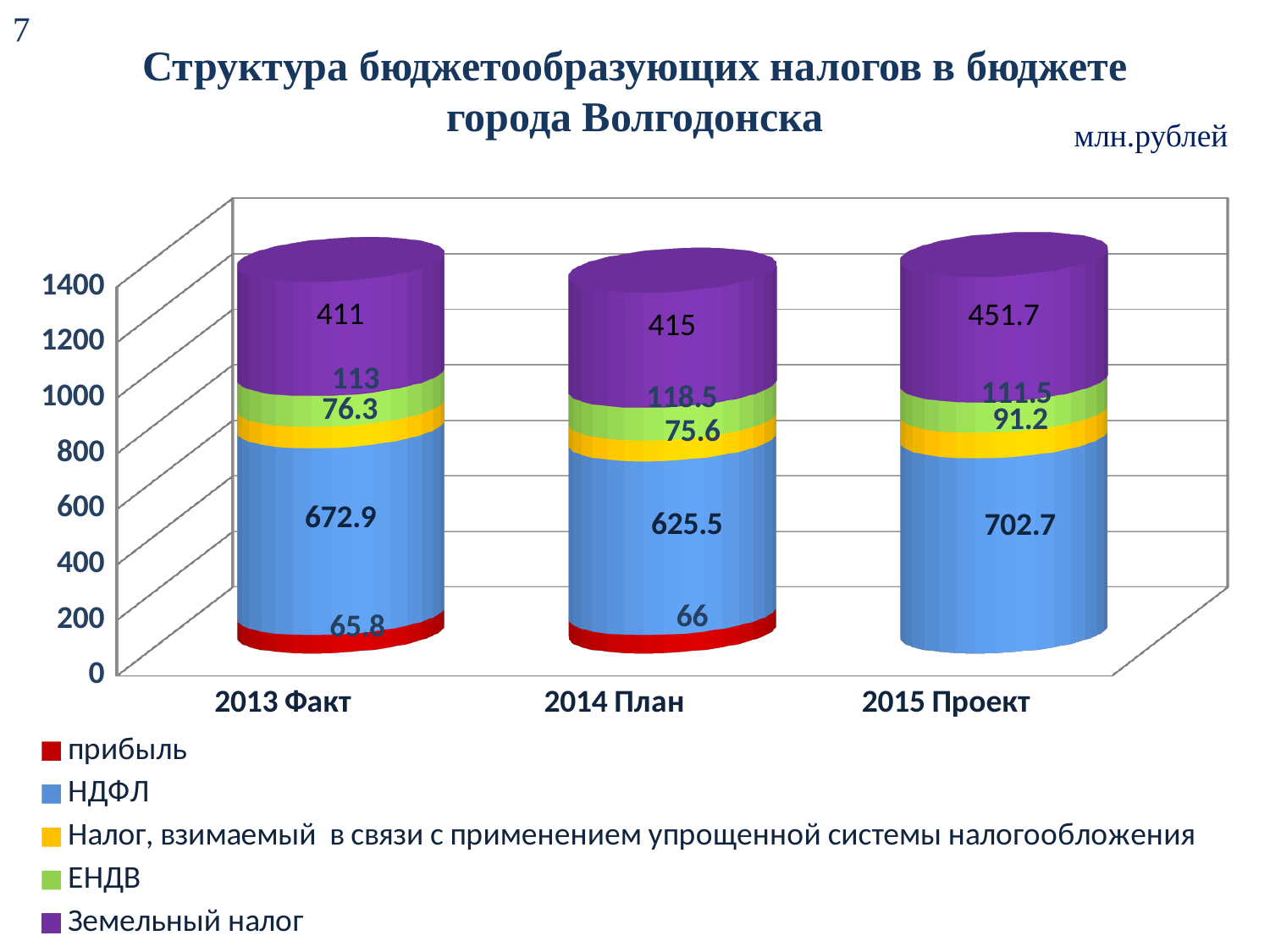
Which category has the highest value for НДФЛ? 2015 Проект Which is larger: ЕНДВ for 2013 Факт or ЕНДВ for 2015 Проект? 2013 Факт What kind of chart is shown on the slide? Stacked bar chart What is the difference between the НДФЛ values for 2015 Проект and 2014 План? 77.2 How many categories are shown on the x axis? 3 What is the value of ЕНДВ for 2014 План? 118.5 What is the value of прибыль for 2014 План? 66 How many series does the legend list? 5 Which category has the lowest value for Земельный налог? 2013 Факт What is the value of Земельный налог for 2013 Факт? 411 What is the value of НДФЛ for 2015 Проект? 702.7 What is the total of the stacked bar for 2013 Факт? 1339